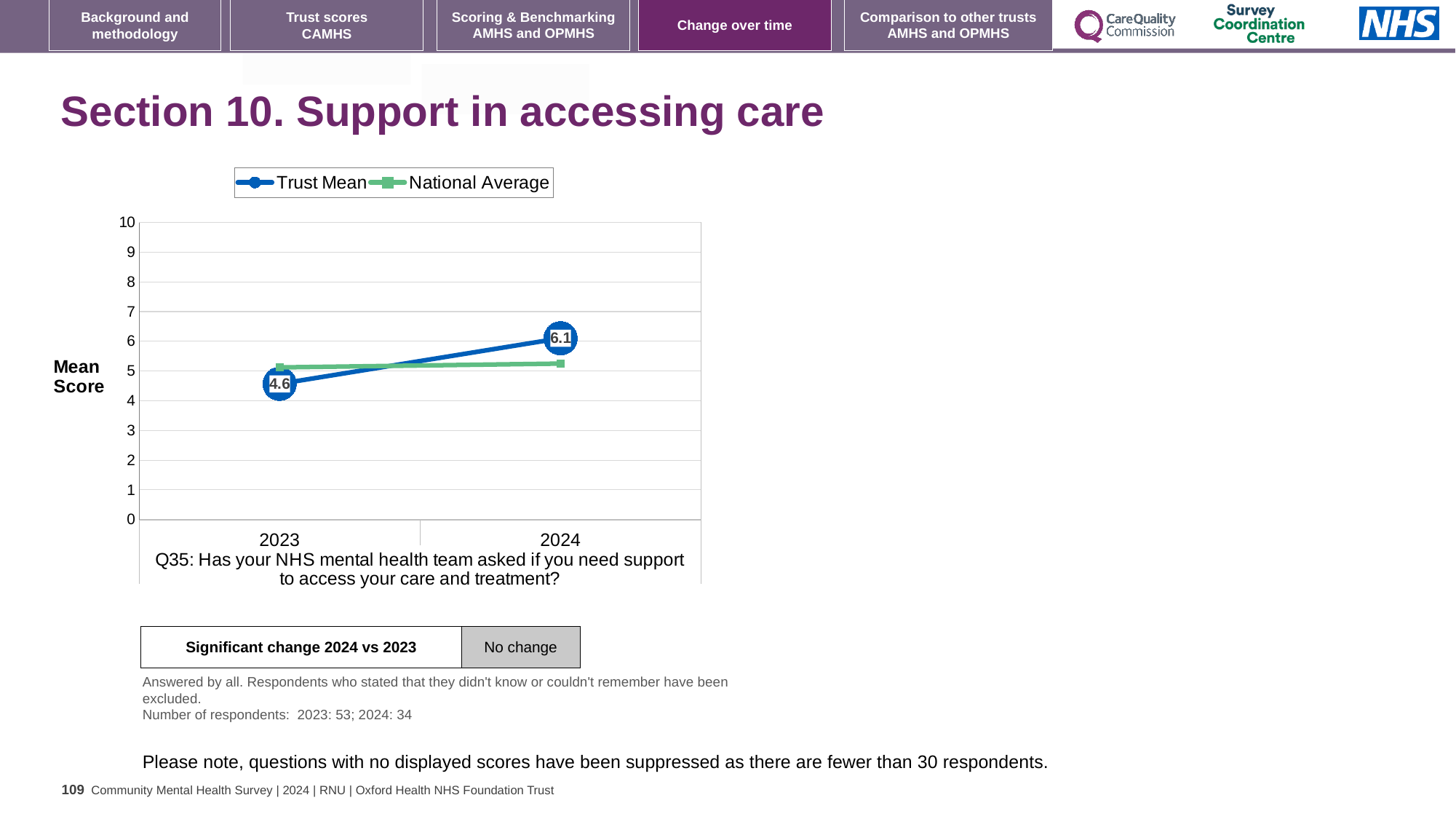
Is the National Average value for 2024 greater or less than 6? less In which year is the Trust Mean score lower? 2023 In which year is the Trust Mean score higher? 2024 What is the Trust Mean score for 2024? 6.1 What is the Trust Mean score for 2023? 4.6 What is the label on the vertical axis of the chart? Mean Score In 2023, which is larger: the Trust Mean or the National Average? National Average Does the Trust Mean rise or fall from 2023 to 2024? rise In 2024, which is larger: the Trust Mean or the National Average? Trust Mean By how much did the Trust Mean score change from 2023 to 2024? 1.5 What kind of chart is shown on the slide? line chart How many series does the legend list? 2